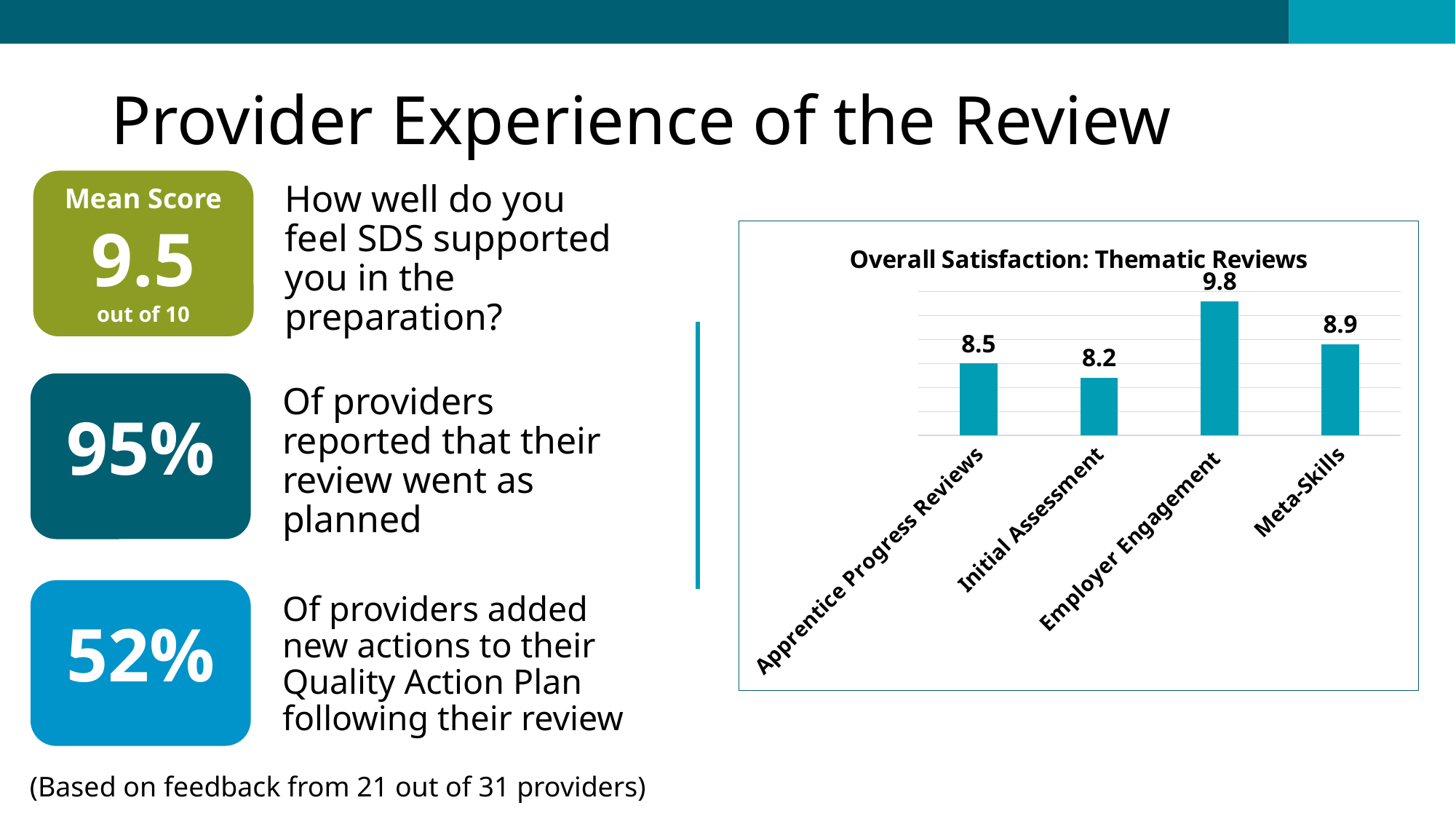
How many categories are shown in the chart? 4 What is the difference between the values for Meta-Skills and Apprentice Progress Reviews? 0.4 Which is larger, the value for Meta-Skills or the value for Apprentice Progress Reviews? Meta-Skills What is the value for Initial Assessment? 8.2 What is the value for Meta-Skills? 8.9 What is the value for Employer Engagement? 9.8 What kind of chart is shown on the slide? Bar chart Which category has the highest overall satisfaction? Employer Engagement Which category has the lowest overall satisfaction? Initial Assessment What is the title of the chart? Overall Satisfaction: Thematic Reviews What is the difference between the values for Employer Engagement and Initial Assessment? 1.6 What is the value for Apprentice Progress Reviews? 8.5